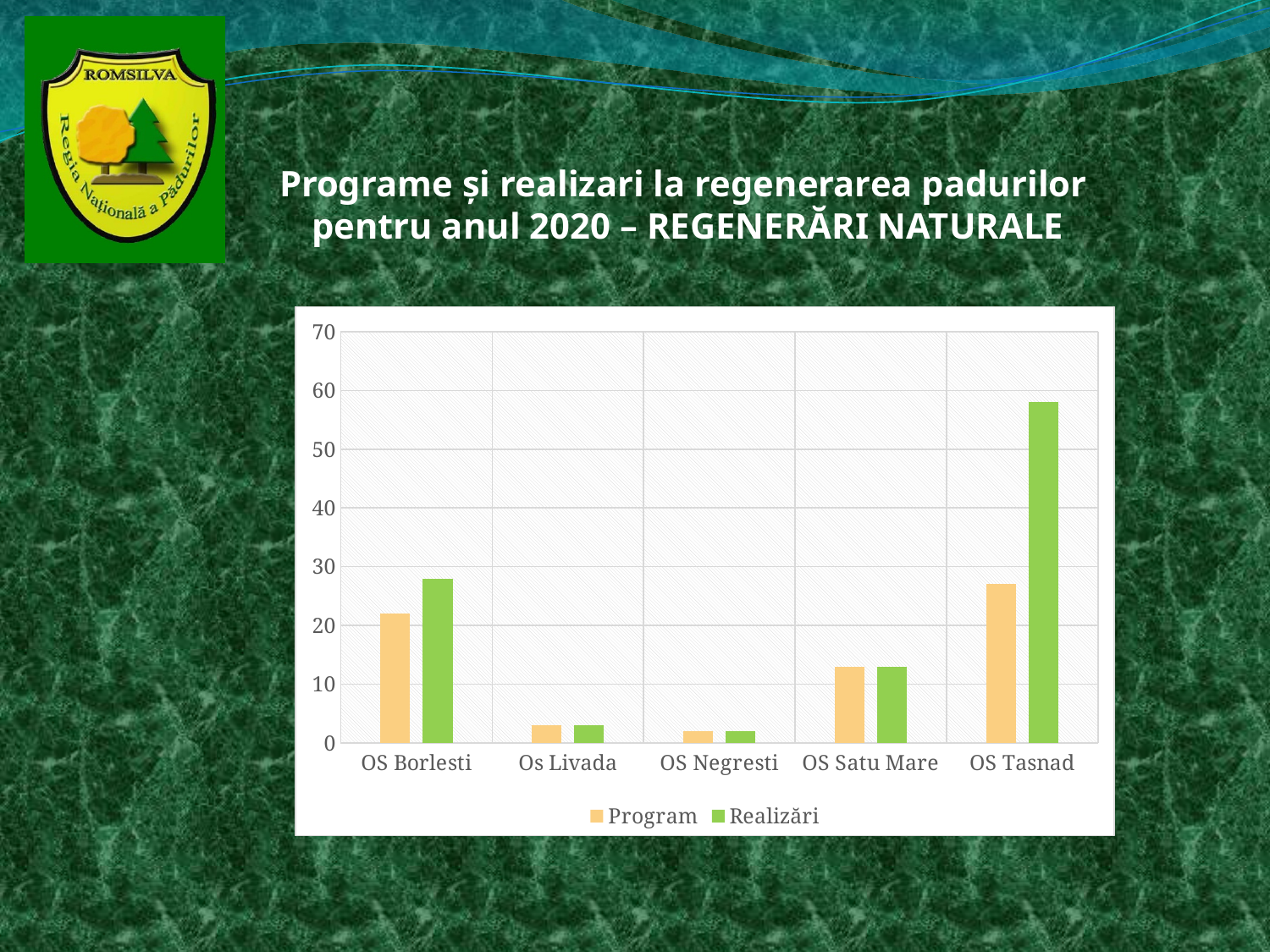
What kind of chart is shown on the slide? bar chart Is the Realizări value for OS Borlesti greater or less than 30? less Which series is shown in green in the chart? Realizări Is the Realizări value for OS Tasnad greater or less than 50? greater Which category has the highest Program value? OS Tasnad Is the Realizări value for Os Livada greater or less than 10? less For OS Borlesti, which is larger: the Program value or the Realizări value? Realizări How many series does the chart legend list? 2 How many categories are shown on the x axis of the chart? 5 Which category has the highest Realizări value? OS Tasnad